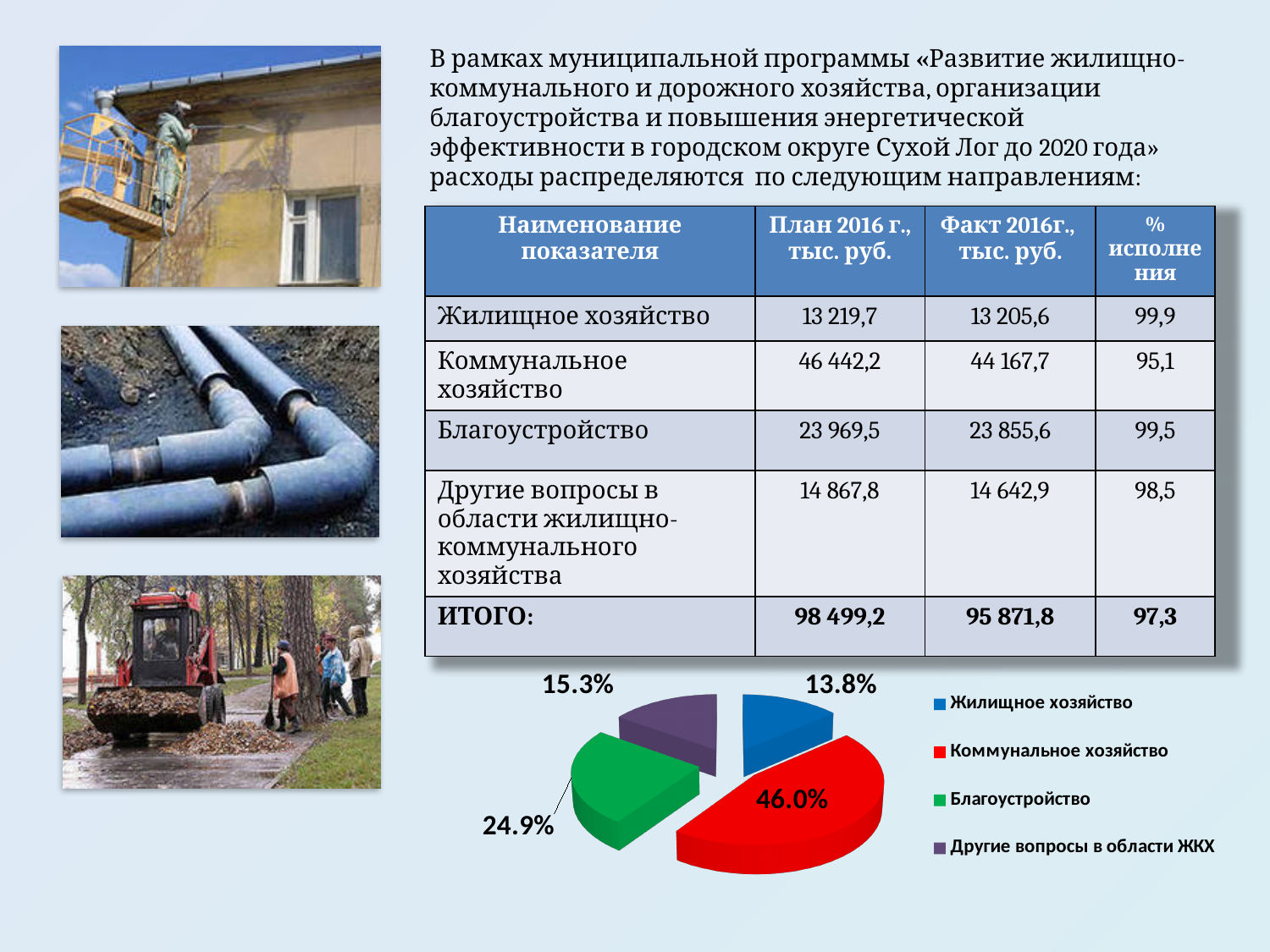
In the pie chart, what share does Коммунальное хозяйство have? 46.0% In the pie chart, which is larger: the share of Благоустройство or the share of Другие вопросы в области ЖКХ? Благоустройство Which category has the smallest slice in the pie chart? Жилищное хозяйство In the pie chart, what share does Жилищное хозяйство have? 13.8% In the pie chart, what is the difference in percentage points between Коммунальное хозяйство and Благоустройство? 21.1 In the pie chart, what share does Благоустройство have? 24.9% How many slices does the pie chart have? 4 What colour is the Коммунальное хозяйство slice in the pie chart? Red What kind of chart is shown at the bottom of the slide? Pie chart Which category has the largest slice in the pie chart? Коммунальное хозяйство How many entries does the pie chart legend list? 4